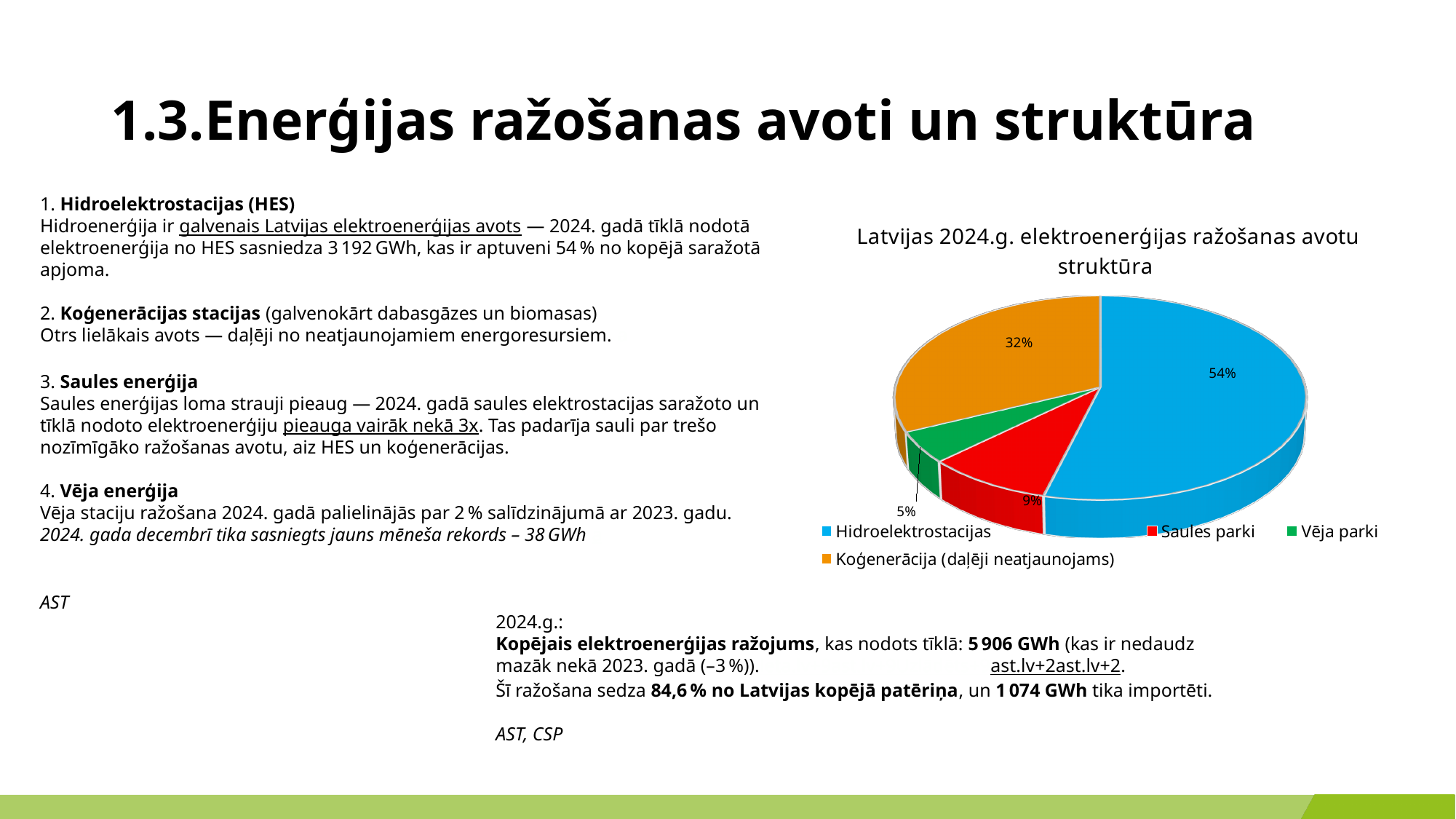
What share of the pie does Vēja parki have? 5% Which category has the largest slice of the pie? Hidroelektrostacijas What is the difference in percentage points between the Hidroelektrostacijas share and the Koģenerācija (daļēji neatjaunojams) share? 22 percentage points Which is larger, the share for Saules parki or the share for Vēja parki? Saules parki How many slices does the pie chart have? 4 What is the title of the chart? Latvijas 2024.g. elektroenerģijas ražošanas avotu struktūra Which category has the smallest slice of the pie? Vēja parki What share of the pie does Saules parki have? 9% What share of the pie does Koģenerācija (daļēji neatjaunojams) have? 32% How many entries does the legend list? 4 What type of chart is shown on the slide? pie chart